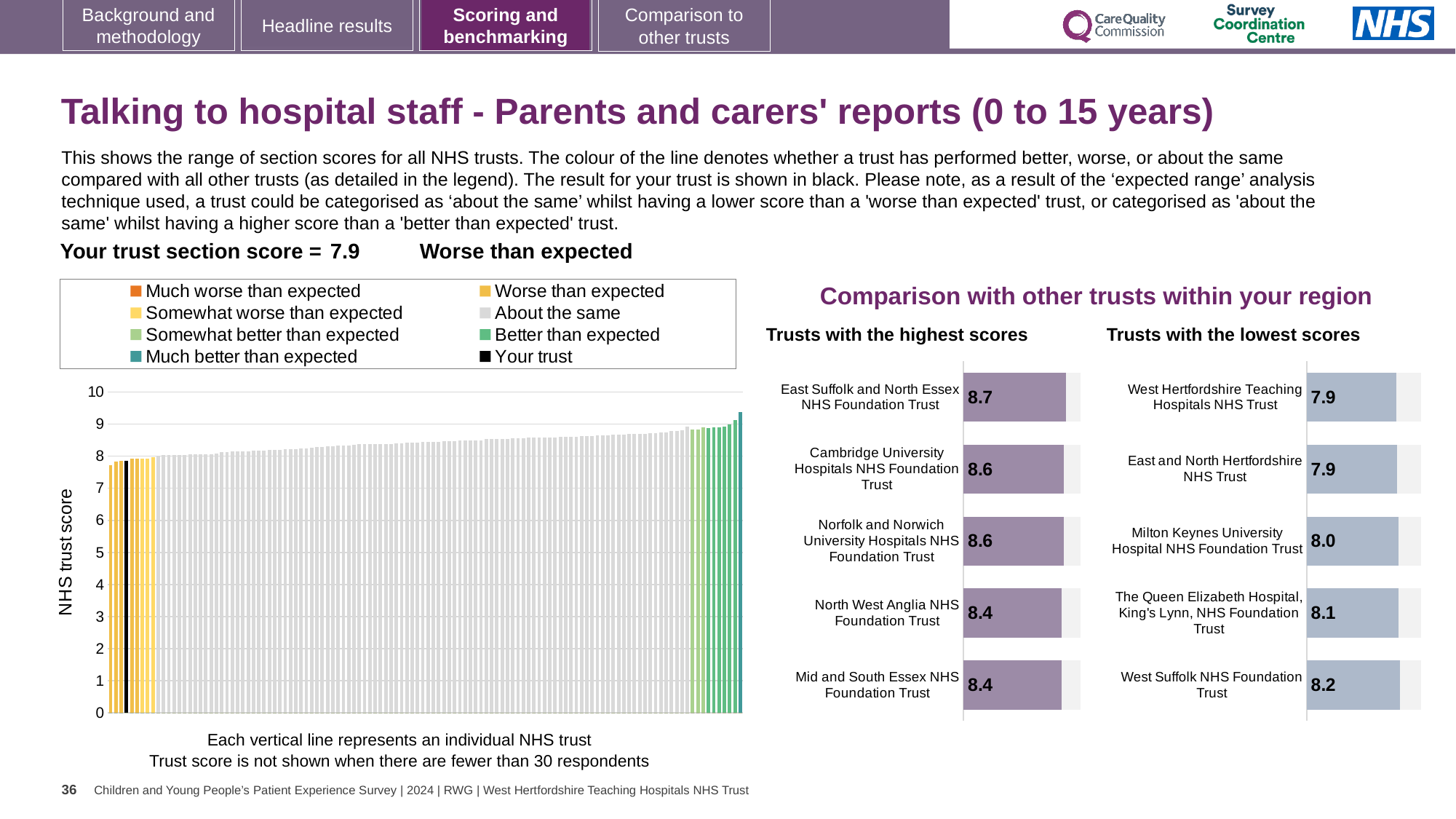
In the 'Trusts with the highest scores' chart, what is the score for East Suffolk and North Essex NHS Foundation Trust? 8.7 In the 'Trusts with the highest scores' chart, what is the difference between the scores of East Suffolk and North Essex NHS Foundation Trust and Mid and South Essex NHS Foundation Trust? 0.3 In the 'Trusts with the lowest scores' chart, which trust has the highest score? West Suffolk NHS Foundation Trust In the 'Trusts with the lowest scores' chart, what is the score for Milton Keynes University Hospital NHS Foundation Trust? 8.0 In the 'Trusts with the lowest scores' chart, which has the larger score: Milton Keynes University Hospital NHS Foundation Trust or The Queen Elizabeth Hospital, King's Lynn, NHS Foundation Trust? The Queen Elizabeth Hospital, King's Lynn, NHS Foundation Trust In the 'Trusts with the lowest scores' chart, what is the score for West Suffolk NHS Foundation Trust? 8.2 In the large 'NHS trust score' chart on the left, do the values rise or fall from left to right along the x axis? rise How many entries does the legend of the large 'NHS trust score' chart on the left list? 8 In the 'Trusts with the highest scores' chart, which trust has the highest score? East Suffolk and North Essex NHS Foundation Trust In the 'Trusts with the lowest scores' chart, what is the difference between the scores of West Suffolk NHS Foundation Trust and West Hertfordshire Teaching Hospitals NHS Trust? 0.3 In the 'Trusts with the highest scores' chart, how many trusts are shown? 5 In the 'Trusts with the highest scores' chart, what is the score for North West Anglia NHS Foundation Trust? 8.4